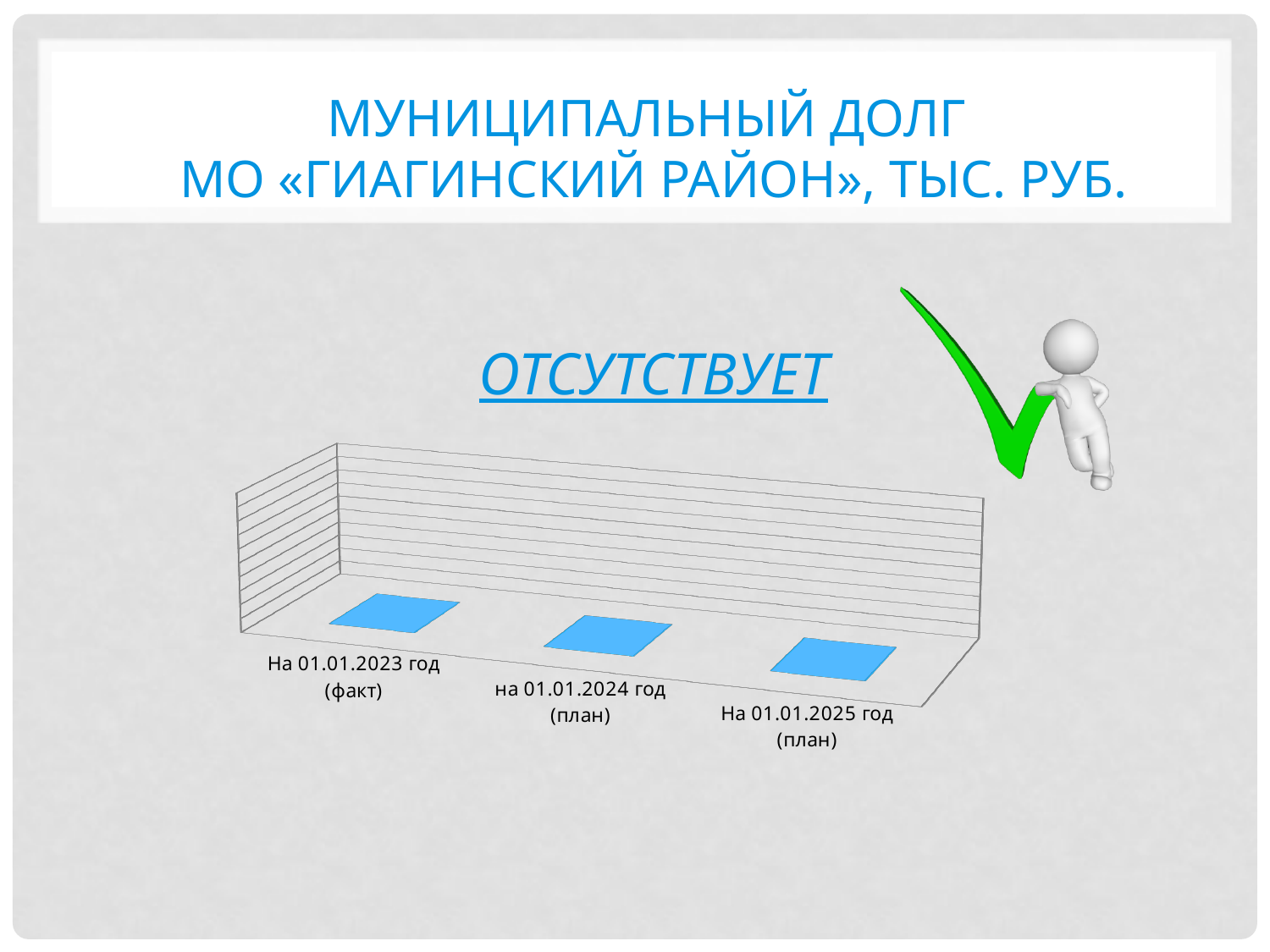
What is the title of the slide containing the chart? Муниципальный долг МО «Гиагинский район», тыс. руб. What is the label of the last category on the x axis? На 01.01.2025 год (план) What is the label of the first category on the x axis? На 01.01.2023 год (факт) In what units is the municipal debt expressed according to the slide title? тыс. руб. How many categories are shown on the x axis of the chart? 3 What word is written above the chart describing the municipal debt? ОТСУТСТВУЕТ What is the label of the middle category on the x axis? на 01.01.2024 год (план) Which category on the x axis is marked as fact (факт) rather than plan? На 01.01.2023 год How many categories on the x axis are marked as plan (план)? 2 What kind of chart is shown on the slide? bar chart